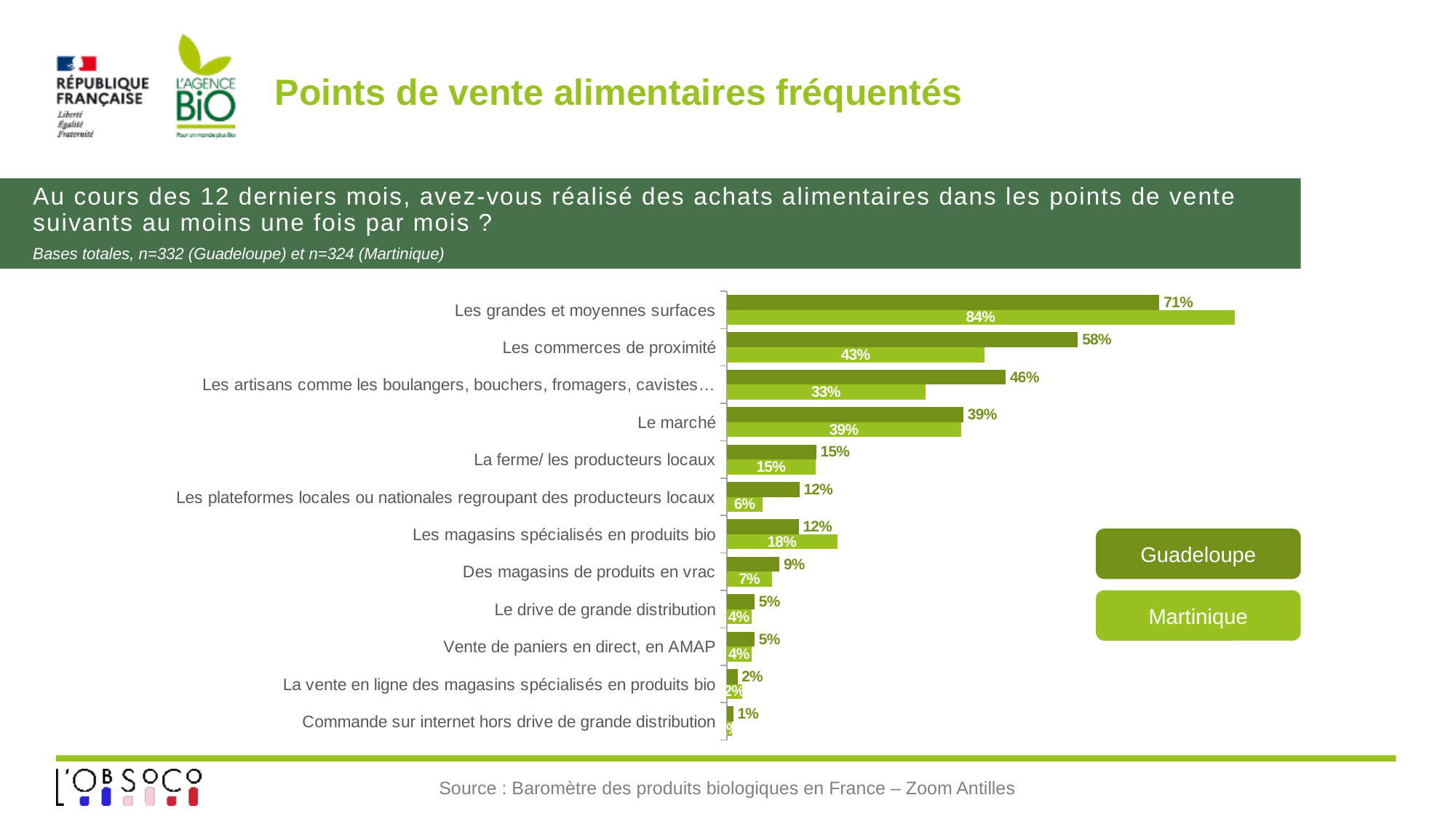
What is the difference between the Guadeloupe and Martinique values for "Les artisans comme les boulangers, bouchers, fromagers, cavistes…"? 13% What kind of chart is shown on the slide? Bar chart How many series does the legend list? 2 What is the difference between the Martinique and Guadeloupe values for "Les grandes et moyennes surfaces"? 13% What is the Martinique value for "Les commerces de proximité"? 43% For "Les magasins spécialisés en produits bio", which is larger, the Guadeloupe value or the Martinique value? Martinique Which category has the highest Martinique value? Les grandes et moyennes surfaces What is the Martinique value for "Les magasins spécialisés en produits bio"? 18% What is the Guadeloupe value for "Les grandes et moyennes surfaces"? 71% For "Les plateformes locales ou nationales regroupant des producteurs locaux", which is larger, the Guadeloupe value or the Martinique value? Guadeloupe Which category has the lowest Guadeloupe value? Commande sur internet hors drive de grande distribution How many categories (points de vente) are shown in the chart? 12